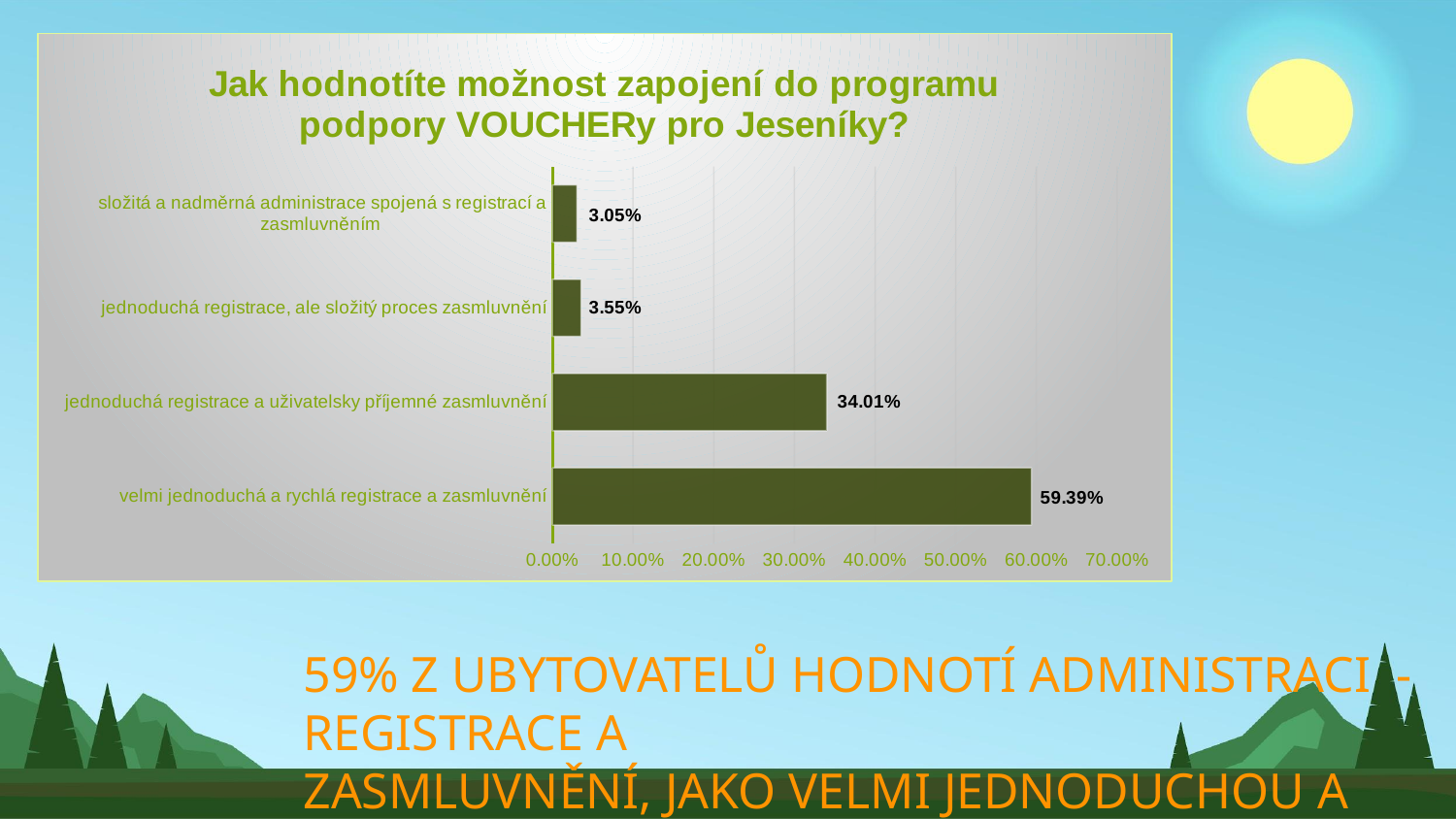
What is the value for "velmi jednoduchá a rychlá registrace a zasmluvnění"? 59.39% What is the value for "jednoduchá registrace a uživatelsky příjemné zasmluvnění"? 34.01% Which category has the highest value? velmi jednoduchá a rychlá registrace a zasmluvnění What kind of chart is shown on the slide? bar chart Is the value for "jednoduchá registrace a uživatelsky příjemné zasmluvnění" greater or less than 30.00%? greater Which is larger: the value for "jednoduchá registrace, ale složitý proces zasmluvnění" or for "složitá a nadměrná administrace spojená s registrací a zasmluvněním"? jednoduchá registrace, ale složitý proces zasmluvnění What is the value for "jednoduchá registrace, ale složitý proces zasmluvnění"? 3.55% What is the title of the chart? Jak hodnotíte možnost zapojení do programu podpory VOUCHERy pro Jeseníky? Which category has the lowest value? složitá a nadměrná administrace spojená s registrací a zasmluvněním How many categories are shown in the chart? 4 What is the difference between the values for "velmi jednoduchá a rychlá registrace a zasmluvnění" and "jednoduchá registrace a uživatelsky příjemné zasmluvnění"? 25.38% What is the value for "složitá a nadměrná administrace spojená s registrací a zasmluvněním"? 3.05%